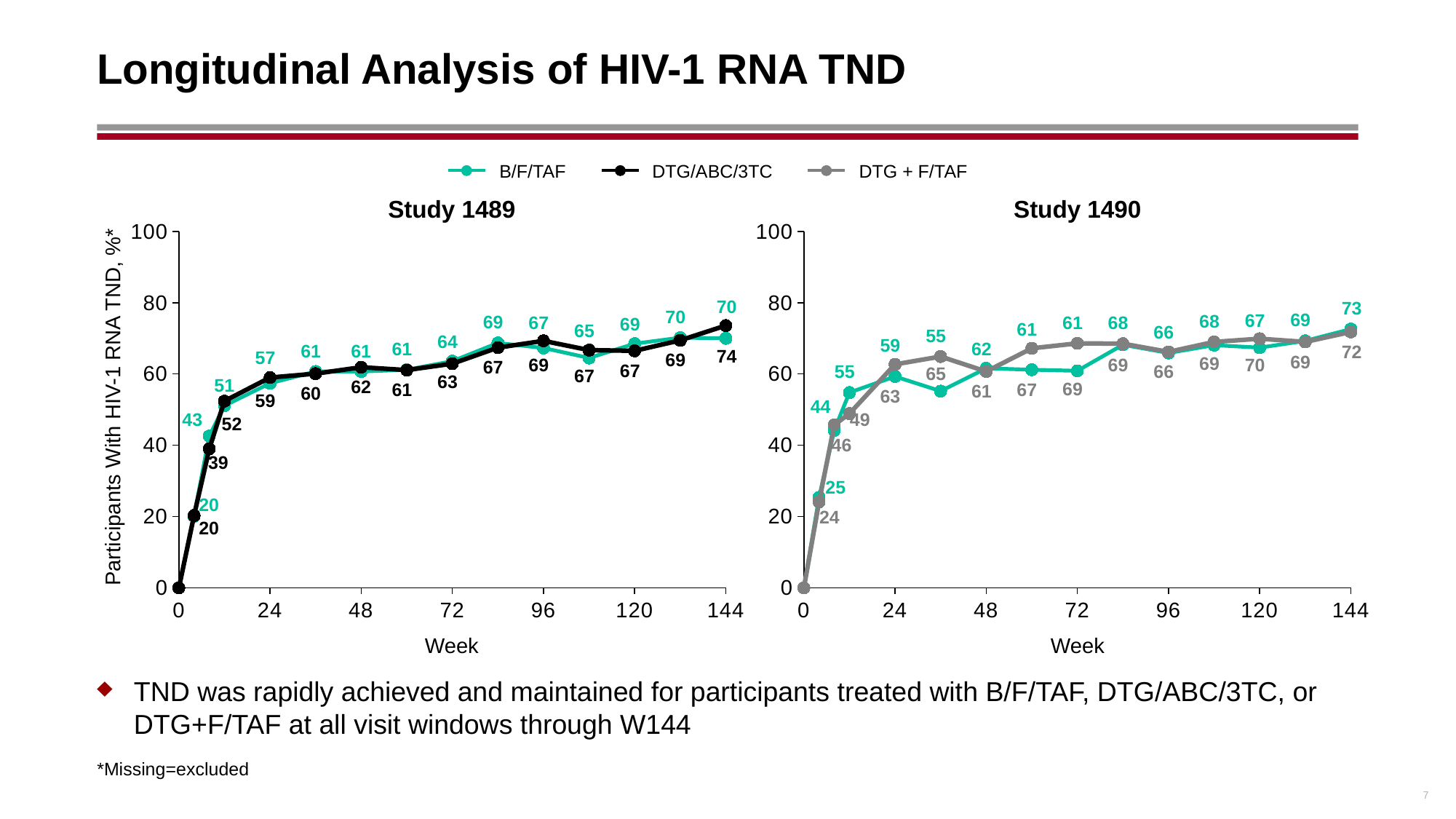
In the Study 1489 chart, is the value for B/F/TAF at week 24 greater or less than 60? less In the Study 1489 chart, what is the difference between DTG/ABC/3TC and B/F/TAF at week 144? 4 How many series does the legend list? 3 In the Study 1490 chart, what is the value for B/F/TAF at week 144? 73 In the Study 1489 chart, what is the value for DTG/ABC/3TC at week 8? 39 In the Study 1490 chart, what is the value for DTG + F/TAF at week 24? 63 In the Study 1489 chart, what is the value for B/F/TAF at week 144? 70 In the Study 1490 chart, do the B/F/TAF values generally rise or fall from week 0 to week 144? Rise What kind of chart is the Study 1489 chart? Line chart In the Study 1490 chart, what is the lowest labelled value for DTG + F/TAF? 24 In the Study 1489 chart, what is the value for DTG/ABC/3TC at week 144? 74 In the Study 1490 chart, which series has the higher value at week 72, B/F/TAF or DTG + F/TAF? DTG + F/TAF